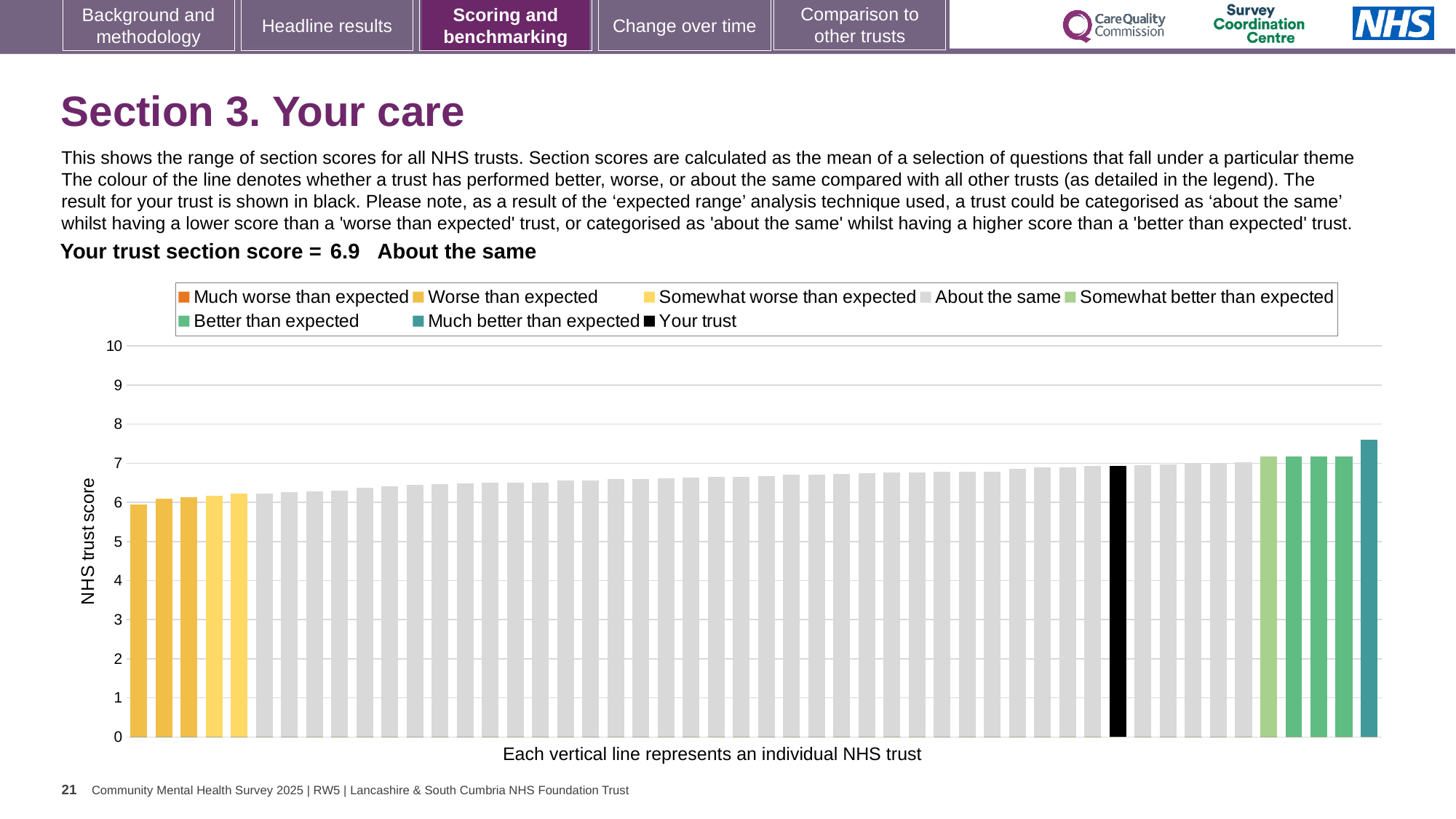
What is the section score for your trust shown on the slide? 6.9 Which performance category is your trust's section score placed in? About the same Is the value of the leftmost bar greater or less than 5? greater What kind of chart is shown on the slide? bar chart Is the value of the rightmost bar greater or less than 8? less How many entries does the chart legend list? 8 Is the value of the black 'Your trust' bar greater or less than 6? greater Which legend category does the tallest bar in the chart belong to? Much better than expected What is the label on the vertical axis of the chart? NHS trust score Do the bar values rise or fall from left to right across the chart? rise